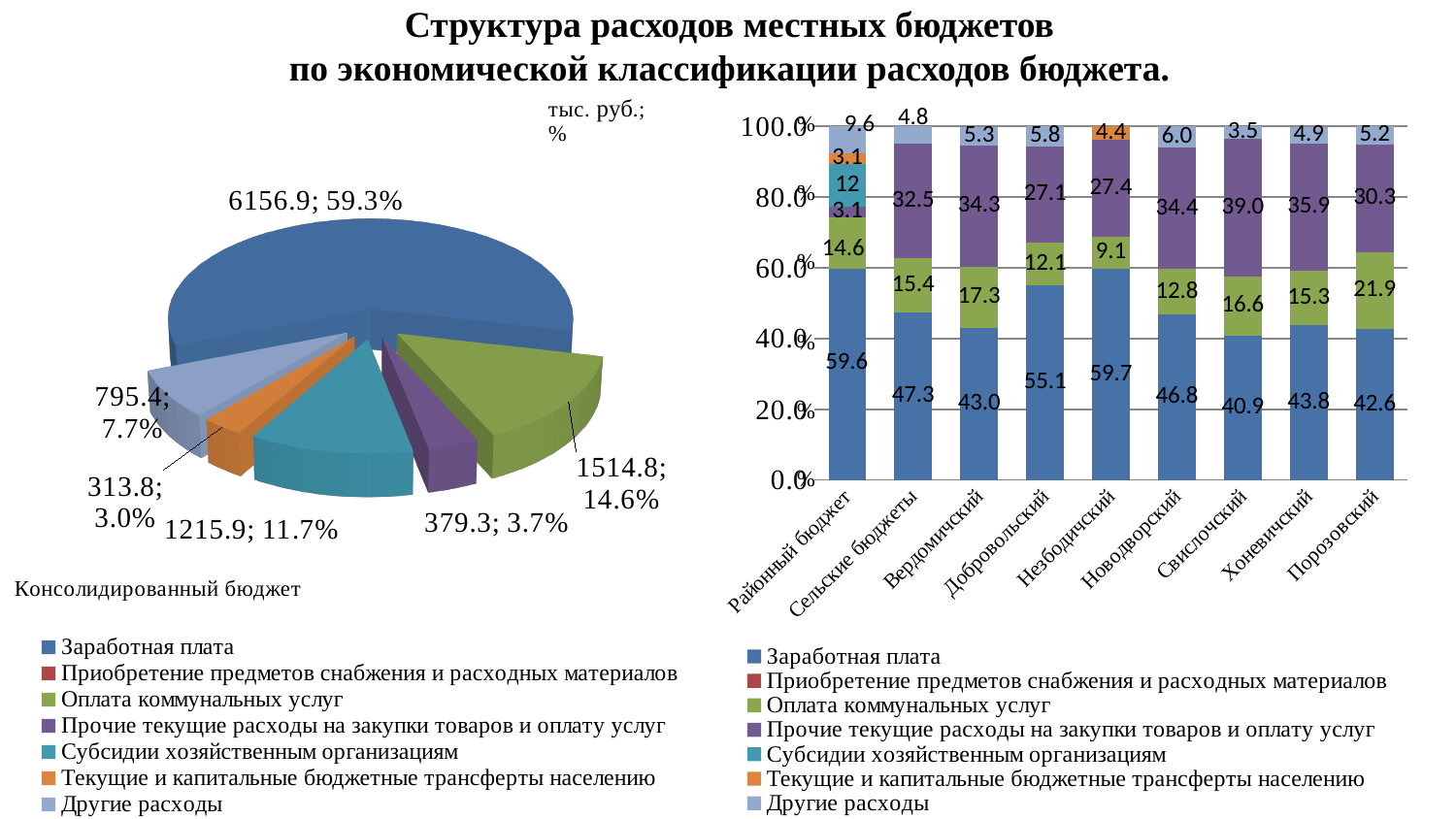
In the stacked bar chart on the right, which category has the highest value for Прочие текущие расходы на закупки товаров и оплату услуг? Свислочский In the stacked bar chart on the right, what is the difference between the Заработная плата values for Районный бюджет and Сельские бюджеты? 12.3 What kind of chart is the chart on the left of the slide? Pie chart In the stacked bar chart on the right, which has the larger value for Заработная плата: Добровольский or Новодворский? Добровольский In the pie chart on the left, which category has the largest slice? Заработная плата In the pie chart on the left, what value is shown for Субсидии хозяйственным организациям? 1215.9; 11.7% In the stacked bar chart on the right, what is the value of Оплата коммунальных услуг for Порозовский? 21.9 How many series does the legend of the stacked bar chart on the right list? 7 In the pie chart on the left, what share of the pie does Оплата коммунальных услуг have? 14.6% In the pie chart on the left (Консолидированный бюджет), what value is shown for Заработная плата? 6156.9; 59.3% In the stacked bar chart on the right, what is the value of Заработная плата for Свислочский? 40.9 How many categories are shown on the x axis of the stacked bar chart on the right? 9